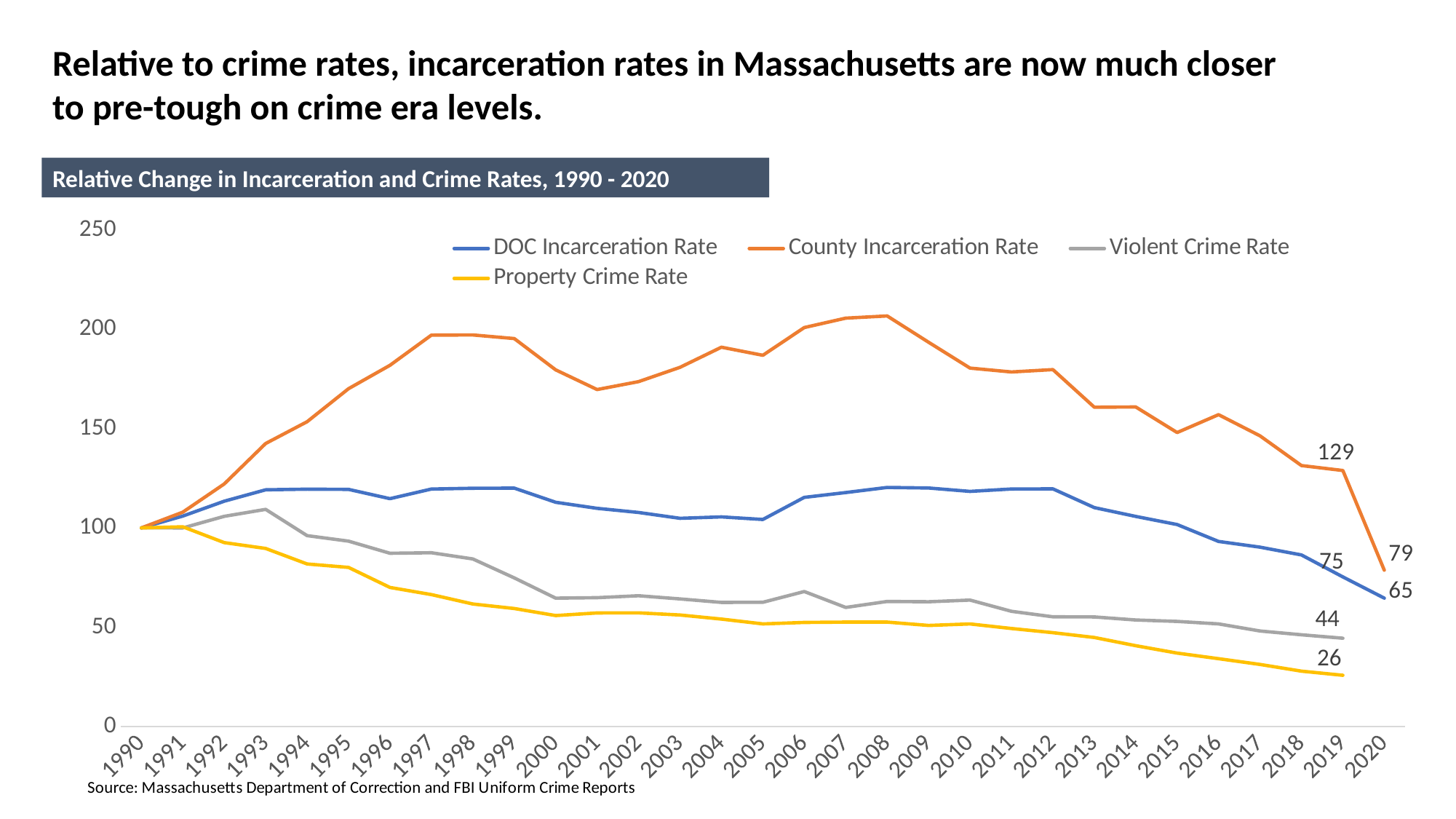
Is the County Incarceration Rate value for 2008 greater or less than 200? greater What is the difference between the County Incarceration Rate and the DOC Incarceration Rate in 2020? 14 How many series does the legend list? 4 By how much did the County Incarceration Rate fall from 2019 to 2020? 50 What is the County Incarceration Rate value in 2020? 79 Does the Property Crime Rate generally rise or fall from 1990 to 2020? fall Which series has the highest value in 2020? County Incarceration Rate What kind of chart is shown on the slide? line chart What is the DOC Incarceration Rate value in 2020? 65